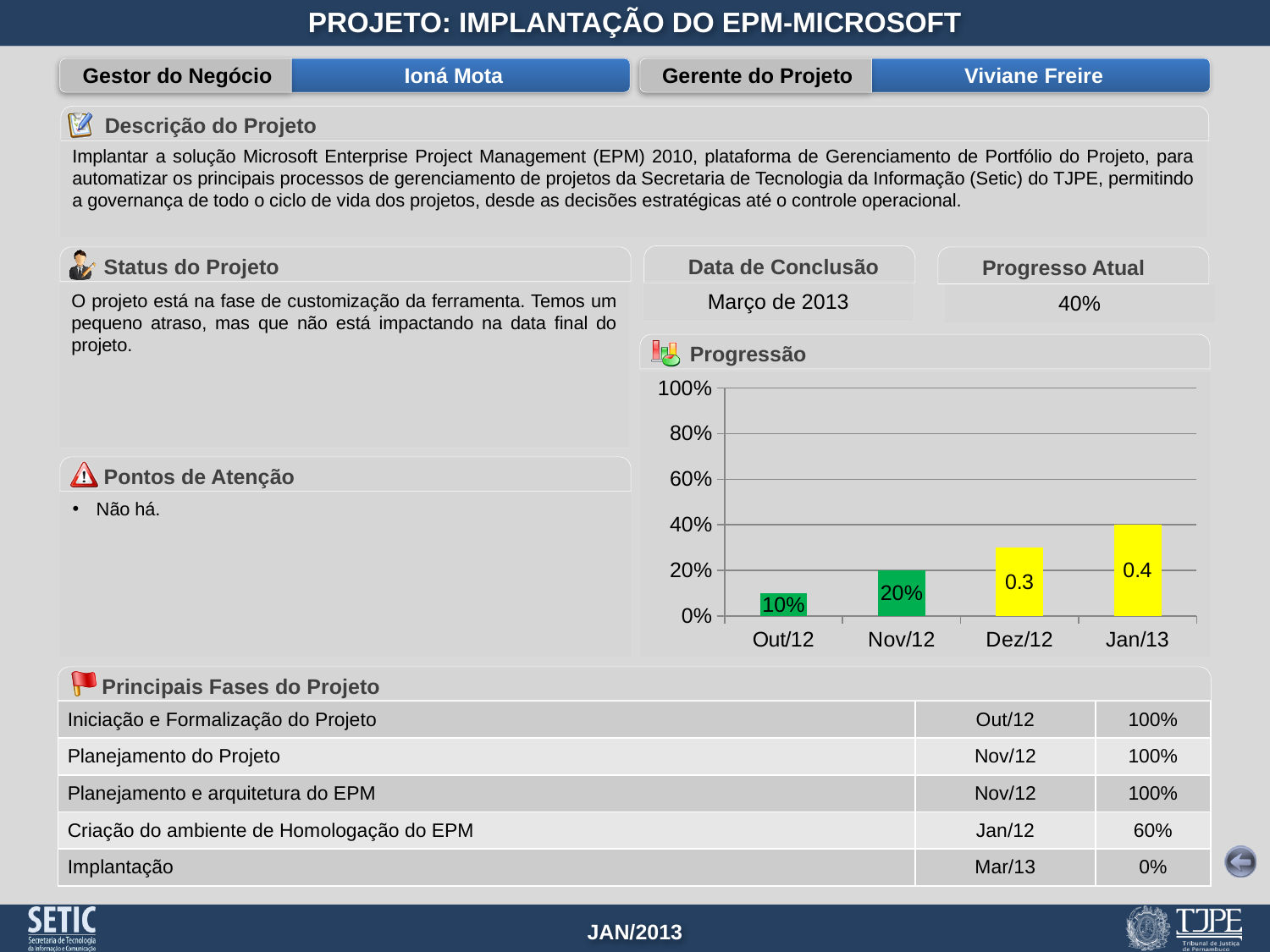
Which is larger in the Progressão chart, the bar for Nov/12 or the bar for Dez/12? Dez/12 What data label is printed on the Dez/12 bar in the Progressão chart? 0.3 What is the difference between the Nov/12 and Out/12 values in the Progressão chart? 10% Which month has the lowest bar in the Progressão chart? Out/12 How many months are plotted in the Progressão chart? 4 Is the value for Jan/13 in the Progressão chart greater or less than 20%? greater Which month has the highest bar in the Progressão chart? Jan/13 What data label is printed on the Jan/13 bar in the Progressão chart? 0.4 What value is shown for Out/12 in the Progressão chart? 10% Do the values in the Progressão chart rise or fall from Out/12 to Jan/13? rise What value is shown for Nov/12 in the Progressão chart? 20% What kind of chart is the Progressão chart? bar chart